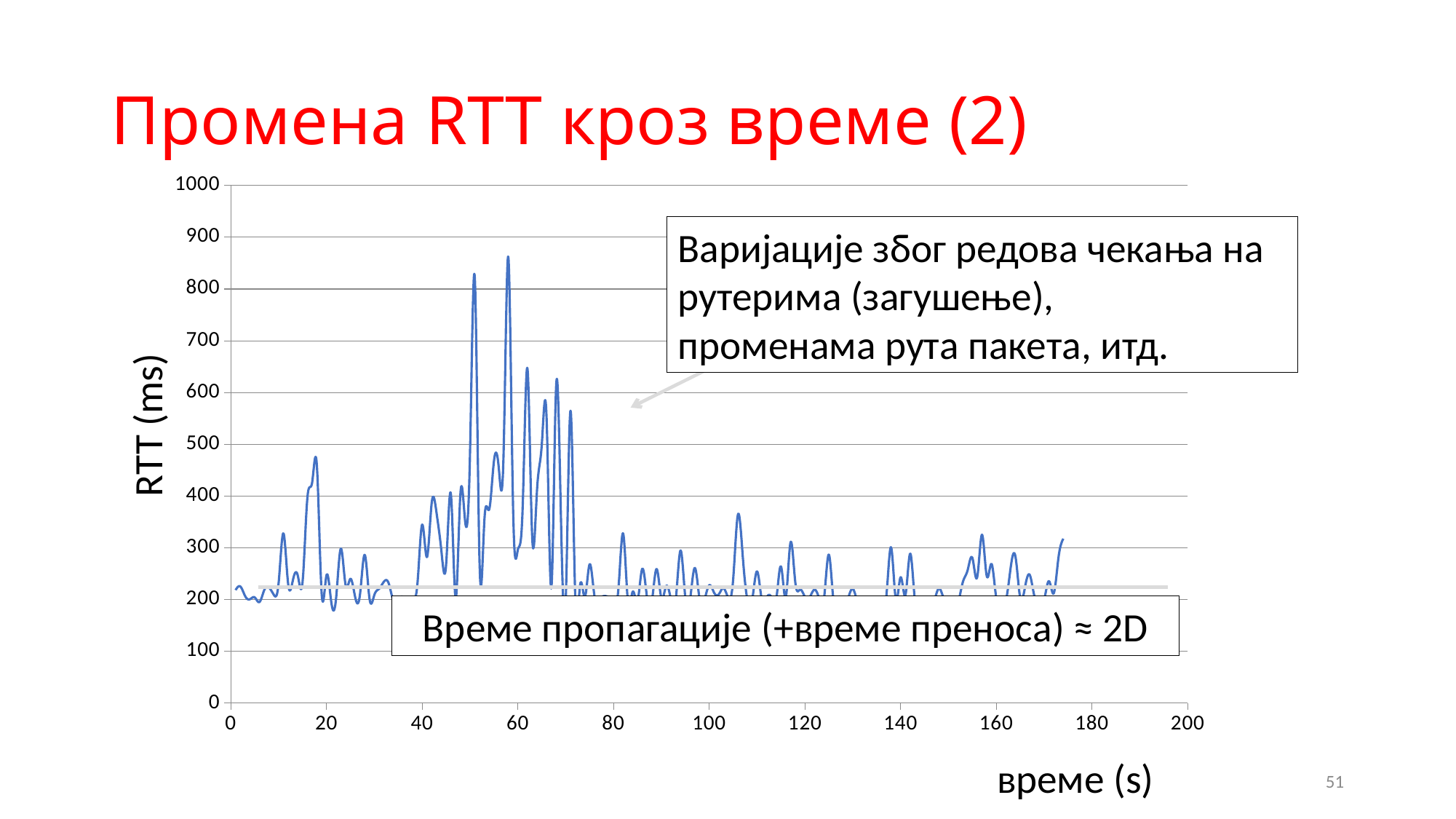
Is the RTT peak near 18 s greater or less than 500? less What is the maximum value shown on the vertical axis? 1000 Is the baseline RTT level (the flat grey line) greater or less than 300? less What is the label of the vertical axis of the chart? RTT (ms) Is the baseline RTT level (the flat grey line) greater or less than 200? greater What kind of chart is shown on the slide? line chart Which is larger: the RTT peak near 58 s or the RTT peak near 18 s? the peak near 58 s What is the label of the horizontal axis of the chart? време (s)